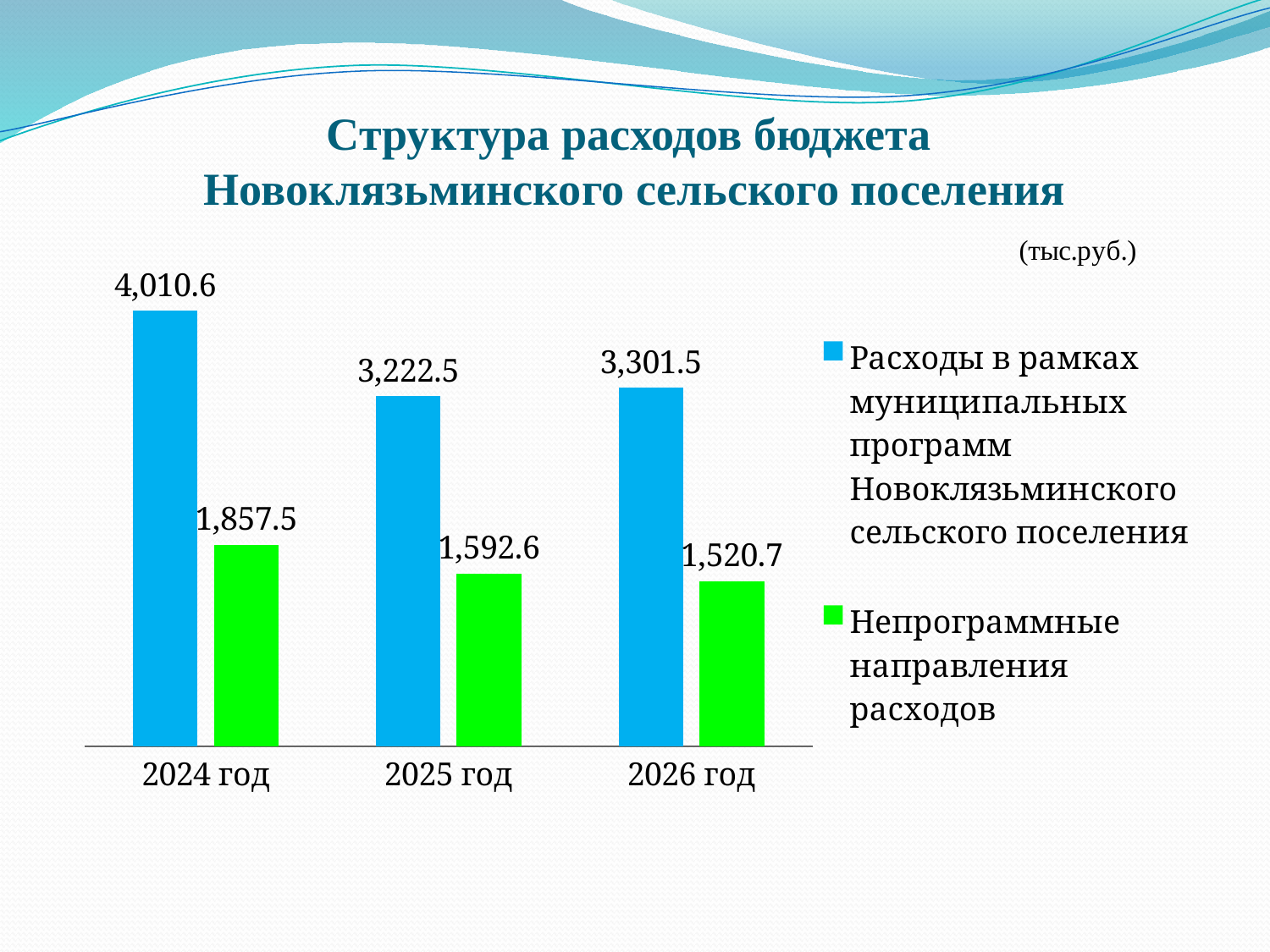
Does the value for 'Непрограммные направления расходов' rise or fall from 2024 год to 2026 год? Fall In which year is the value for 'Расходы в рамках муниципальных программ Новоклязьминского сельского поселения' highest? 2024 год What is the value for 'Расходы в рамках муниципальных программ Новоклязьминского сельского поселения' in 2024 год? 4,010.6 Which is larger: 'Расходы в рамках муниципальных программ Новоклязьминского сельского поселения' in 2025 год or in 2026 год? 2026 год What is the value for 'Непрограммные направления расходов' in 2026 год? 1,520.7 What is the value for 'Непрограммные направления расходов' in 2025 год? 1,592.6 In which year is the value for 'Непрограммные направления расходов' lowest? 2026 год What is the difference between the two series in 2024 год? 2,153.1 How many series does the legend list? 2 How many years are shown on the x axis? 3 What kind of chart is shown on the slide? Bar chart By how much does 'Расходы в рамках муниципальных программ Новоклязьминского сельского поселения' in 2024 год exceed its value in 2025 год? 788.1